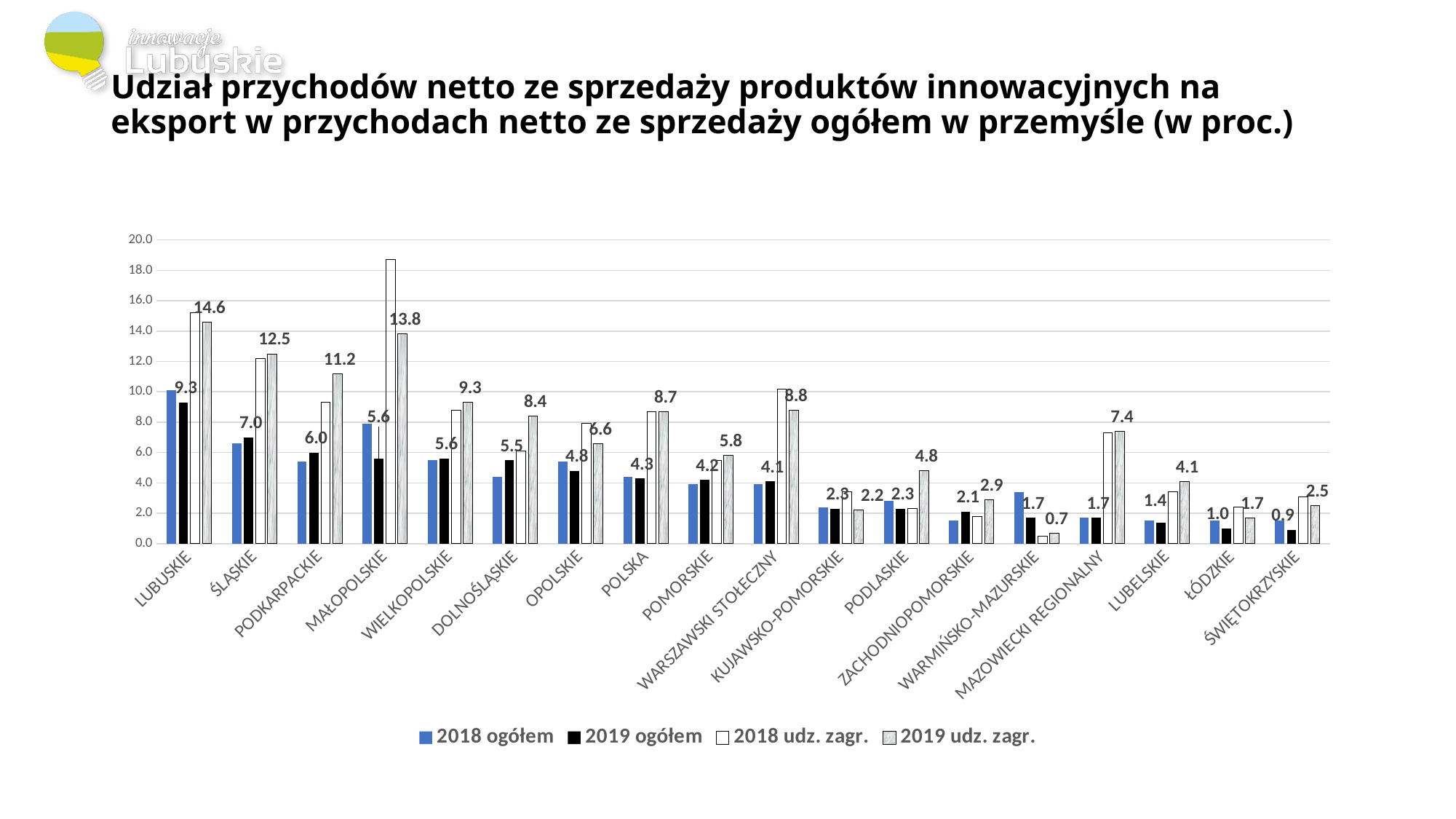
How many series does the legend list? 4 In the 2019 udz. zagr. series, which is larger: ŚLĄSKIE or MAŁOPOLSKIE? MAŁOPOLSKIE Do the values of the 2019 ogółem series rise or fall from left to right along the x axis? fall What is the value of the 2019 ogółem series for LUBUSKIE? 9.3 What kind of chart is shown on the slide? bar chart What is the value of the 2019 udz. zagr. series for WARMIŃSKO-MAZURSKIE? 0.7 Which category has the lowest value in the 2019 ogółem series? ŚWIĘTOKRZYSKIE Is the 2018 udz. zagr. value for MAŁOPOLSKIE greater or less than 18.0? greater Which category has the highest value in the 2019 udz. zagr. series? LUBUSKIE What is the value of the 2019 udz. zagr. series for MAŁOPOLSKIE? 13.8 How many categories are shown on the x axis? 18 For LUBUSKIE, what is the difference between the 2019 udz. zagr. value and the 2019 ogółem value? 5.3